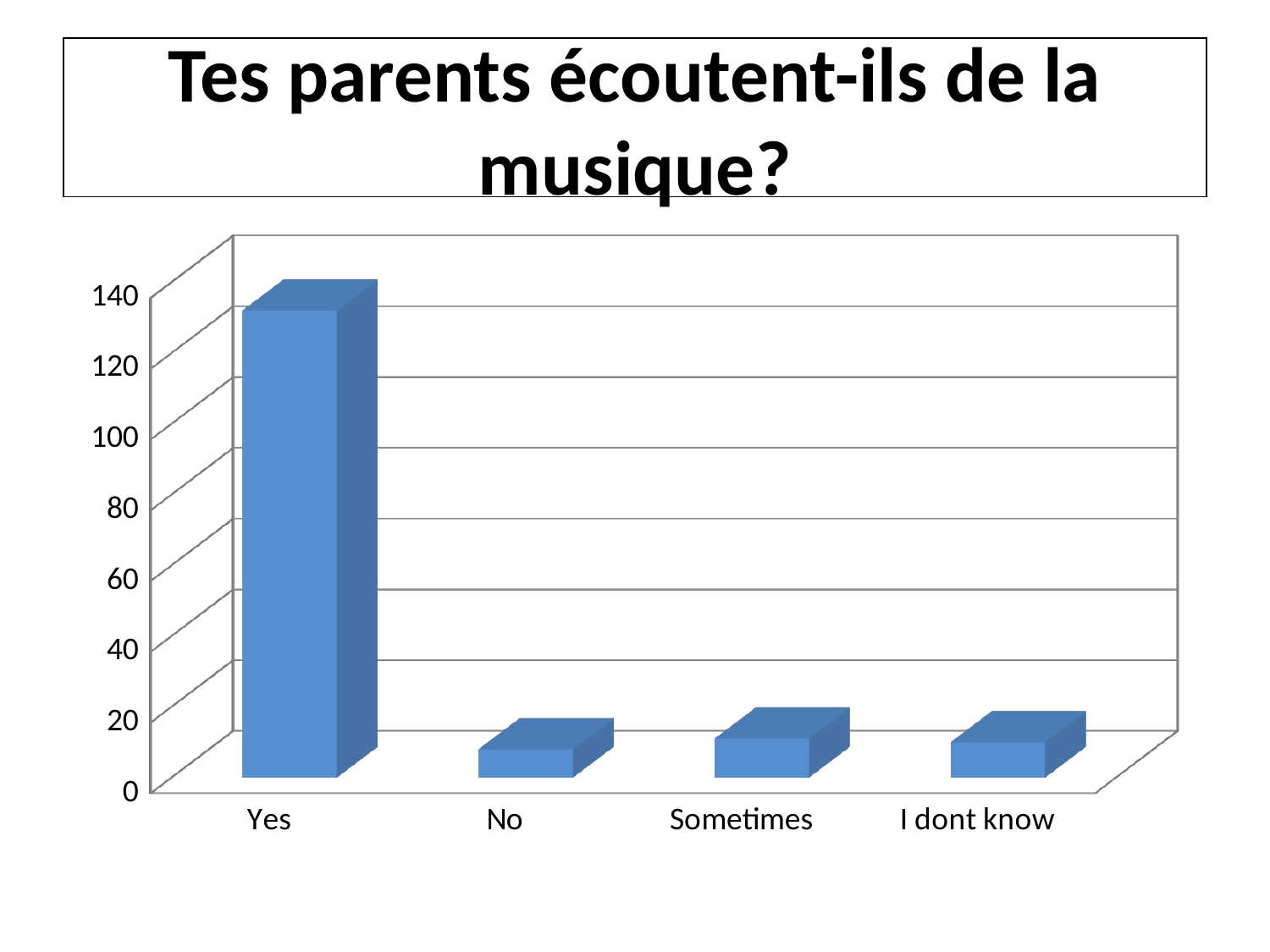
What is the title shown above the chart on the slide? Tes parents écoutent-ils de la musique? Which category has the highest value in the chart? Yes Is the value for I dont know greater or less than 20? less Which is larger, the value for Yes or the value for No? Yes Is the value for Sometimes greater or less than 20? less What is the highest value labelled on the vertical axis of the chart? 140 How many categories are shown on the x axis of the chart? 4 What kind of chart is shown on the slide? bar chart Is the value for Yes greater or less than 120? greater Which is larger, the value for Sometimes or the value for Yes? Yes